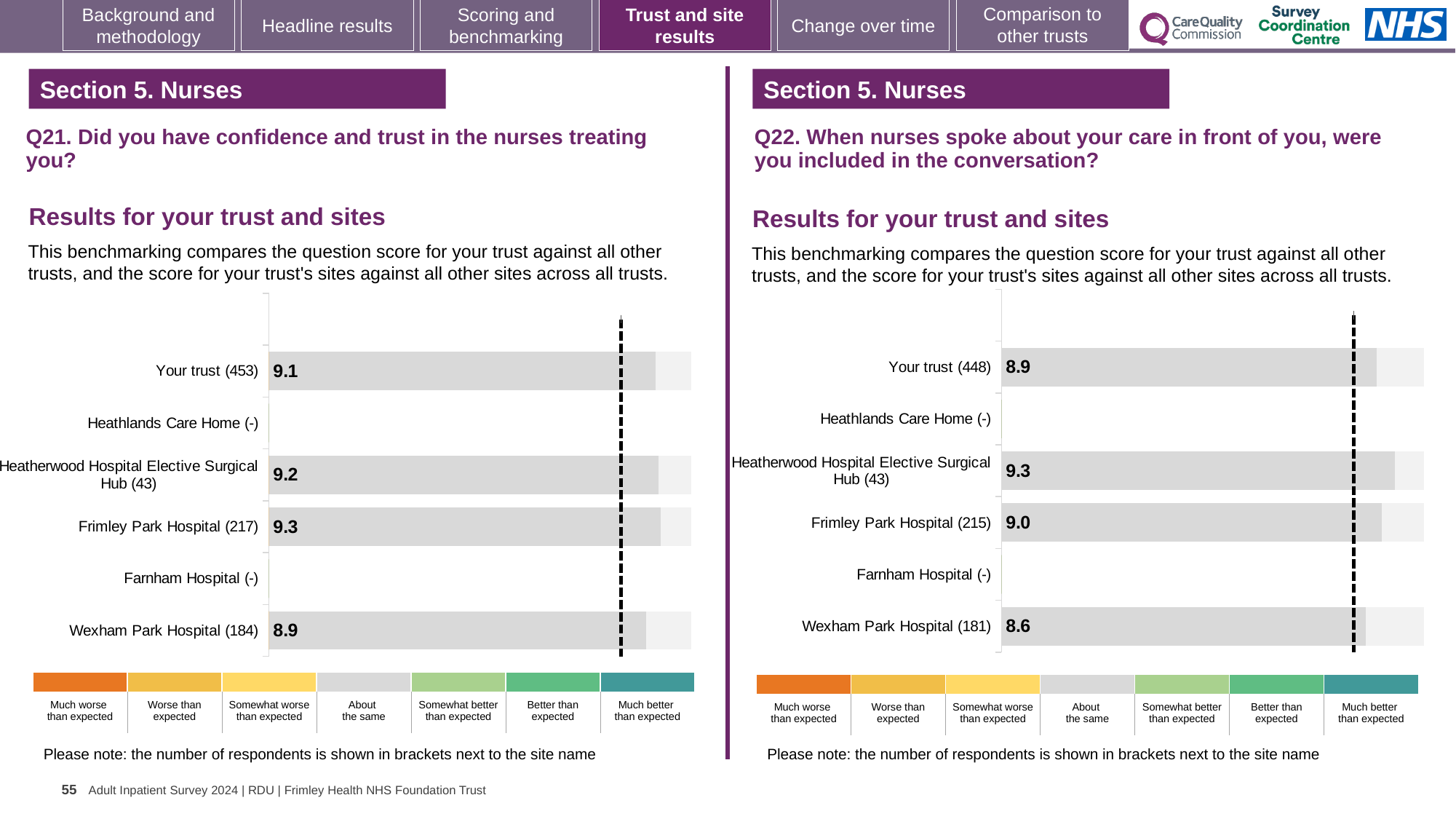
In the Q21 chart on the left, which two sites show no score bar? Heathlands Care Home (-) and Farnham Hospital (-) What kind of chart is used for the Q22 results on the right? Bar chart In the Q21 chart on the left, which site has the lowest score? Wexham Park Hospital (184) In the Q22 chart on the right, which site has the highest score? Heatherwood Hospital Elective Surgical Hub (43) In the Q22 chart on the right, which is larger: the score for Your trust (448) or the score for Frimley Park Hospital (215)? Frimley Park Hospital (215) In the Q22 chart on the right, what is the difference between the scores for Your trust (448) and Wexham Park Hospital (181)? 0.3 In the Q21 chart on the left, what is the score for Your trust (453)? 9.1 In the Q21 chart on the left, what is the score for Frimley Park Hospital (217)? 9.3 How many row labels (trust and sites) are listed on the Q21 chart on the left? 6 In the Q22 chart on the right, what is the score for Heatherwood Hospital Elective Surgical Hub (43)? 9.3 In the Q22 chart on the right, what is the score for Wexham Park Hospital (181)? 8.6 In the Q21 chart on the left, what is the difference between the scores for Frimley Park Hospital (217) and Wexham Park Hospital (184)? 0.4